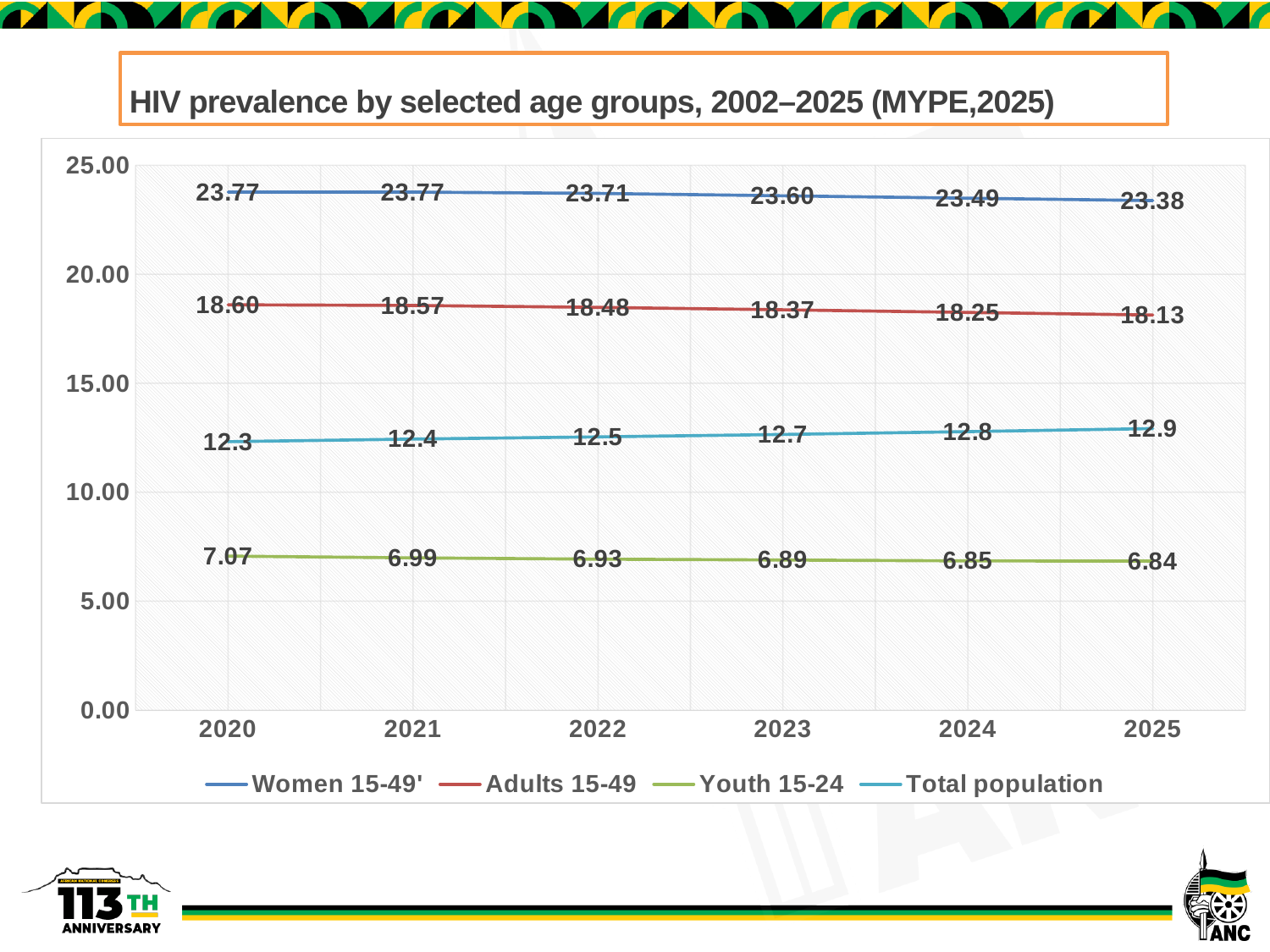
Which series has the highest value in 2025? Women 15-49' Which series has the lowest value in 2020? Youth 15-24 What kind of chart is shown on the slide? line chart Does the Total population series rise or fall from 2020 to 2025? rise How many series does the legend list? 4 What is the value for Youth 15-24 in 2021? 6.99 What is the value for Women 15-49' in 2020? 23.77 Which is larger in 2024: the Adults 15-49 value or the Total population value? Adults 15-49 What is the value for Total population in 2023? 12.7 What is the difference between the Women 15-49' value in 2020 and in 2025? 0.39 How many years are shown on the x axis? 6 What is the value for Adults 15-49 in 2025? 18.13